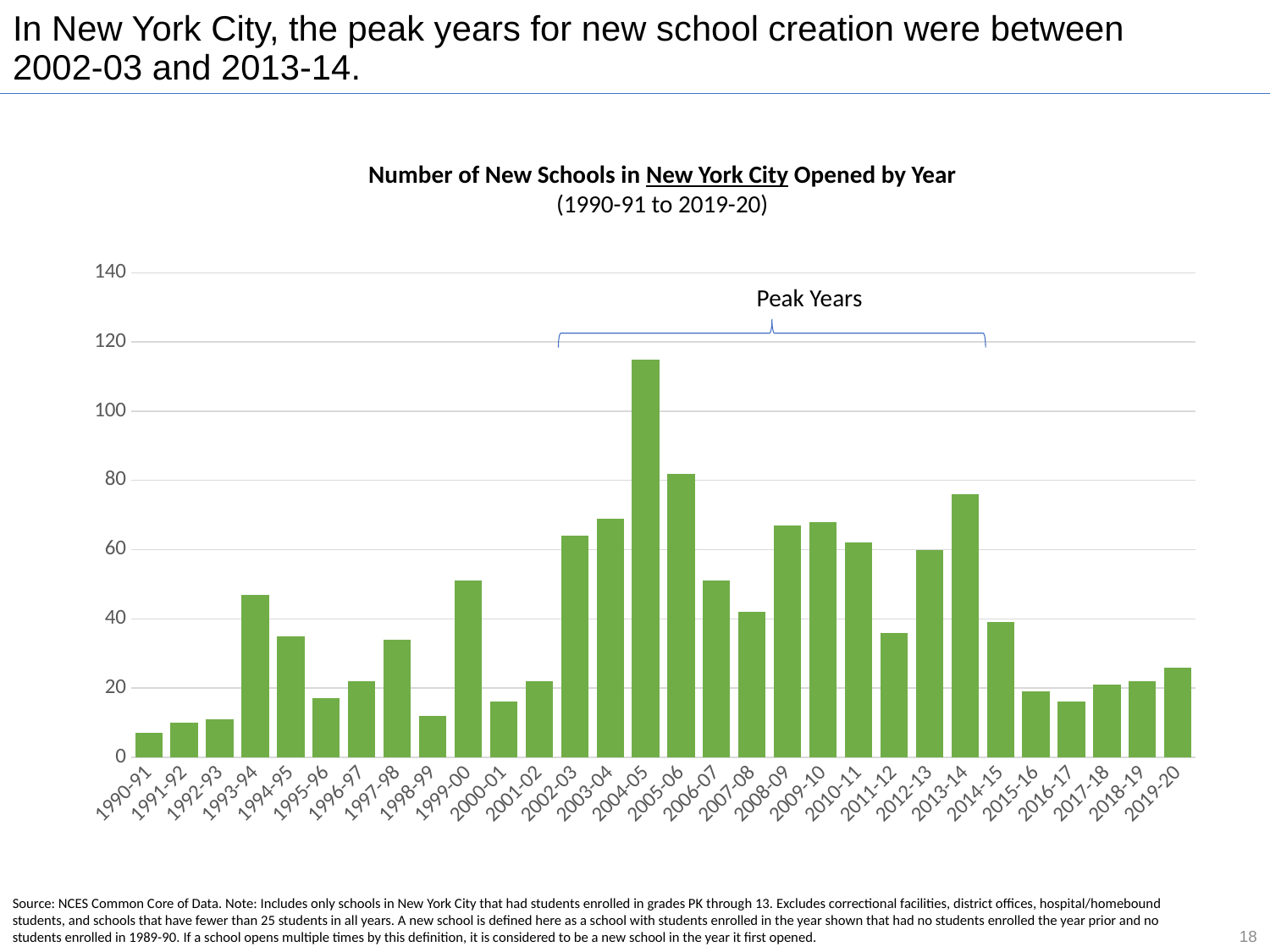
Which school year has the highest number of new schools opened? 2004-05 What label is written above the bracket spanning 2002-03 to 2013-14? Peak Years Is the value for 2013-14 greater or less than 80? less Which year has more new schools, 2004-05 or 2005-06? 2004-05 What kind of chart is shown on the slide? bar chart Do the values rise or fall from 2004-05 to 2007-08? fall Which year has more new schools, 1993-94 or 1998-99? 1993-94 Which school year has the lowest number of new schools opened? 1990-91 Is the value for 1999-00 greater or less than 40? greater Is the value for 2004-05 greater or less than 100? greater How many school years are shown on the x axis? 30